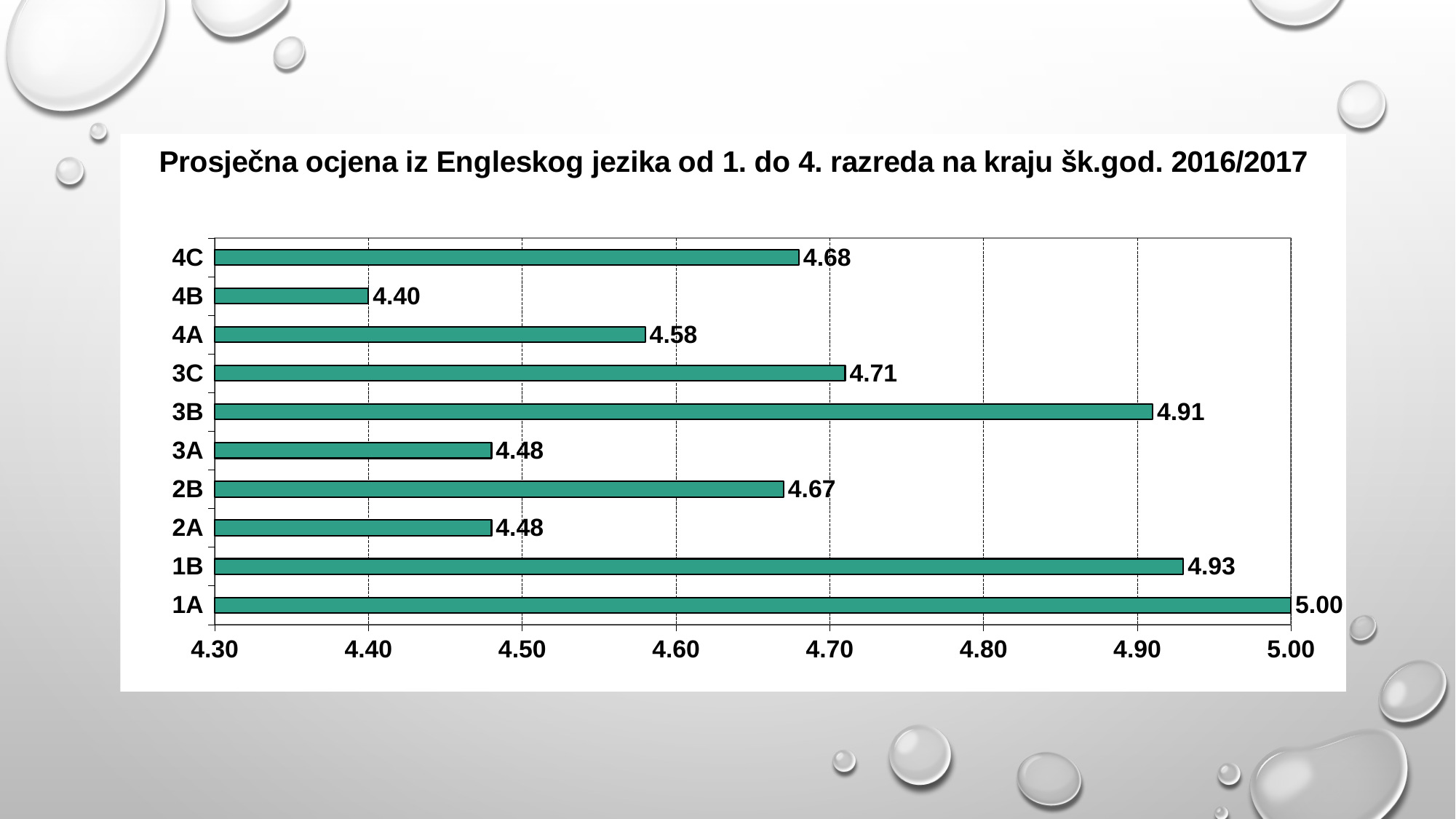
How many classes are shown in the chart? 10 Which class has a higher average grade, 3B or 4C? 3B Is the value for 4A greater or less than 4.60? less Which class has the highest average grade? 1A What type of chart is shown on the slide? bar chart What is the value shown for class 4A? 4.58 What is the average English grade for class 3B? 4.91 What is the difference between the values for 3C and 4C? 0.03 What is the difference between the values for 1B and 4B? 0.53 What is the title of the chart? Prosječna ocjena iz Engleskog jezika od 1. do 4. razreda na kraju šk.god. 2016/2017 Which class has the lowest average grade? 4B What is the value shown for class 2B? 4.67